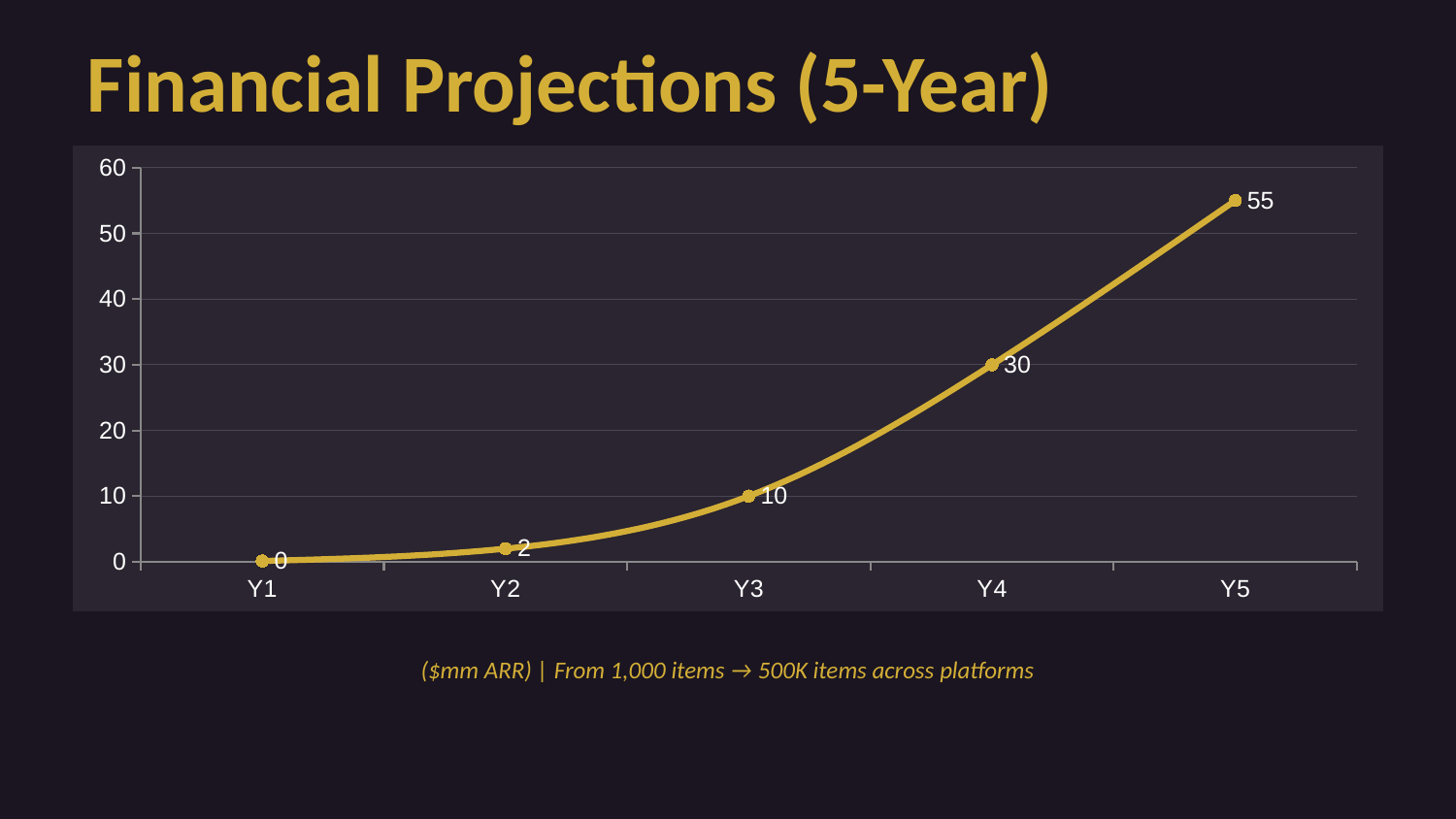
How many years are plotted on the x axis? 5 What is the value for Y1? 0 Which is larger, the value for Y3 or the value for Y4? Y4 What is the value for Y5? 55 What kind of chart is shown on the slide? line chart Which year has the lowest value? Y1 Do the values rise or fall from Y1 to Y5? rise What is the difference between the values for Y5 and Y4? 25 What is the value for Y2? 2 Which year has the highest value? Y5 What is the value for Y3? 10 Is the value for Y4 greater or less than 20? greater